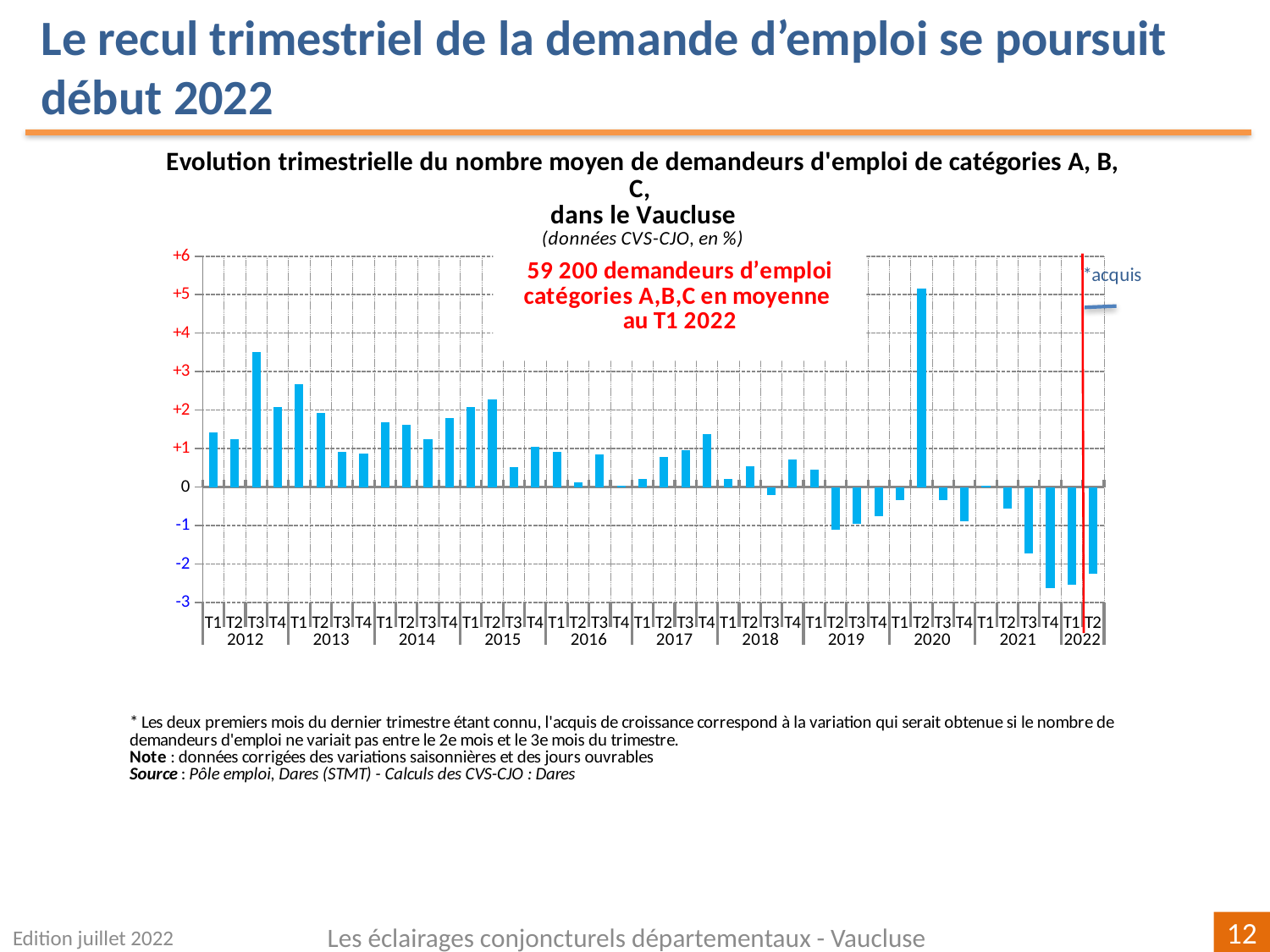
According to the red annotation on the chart, how many demandeurs d'emploi of categories A, B, C were there on average in T1 2022? 59 200 How many quarterly bars are plotted in the chart, from T1 2012 to T2 2022? 42 Which is larger, the value for T3 2012 or the value for T1 2013? T3 2012 What kind of chart is shown on the slide? bar chart Is the value for T1 2013 greater or less than +2? greater Which is larger, the value for T2 2020 or the value for T3 2012? T2 2020 Is the value for T3 2021 greater or less than -1? less Is the value for T3 2012 greater or less than +3? greater Do the values rise or fall across the four quarters of 2021? fall Which quarter has the highest value in the chart? T2 2020